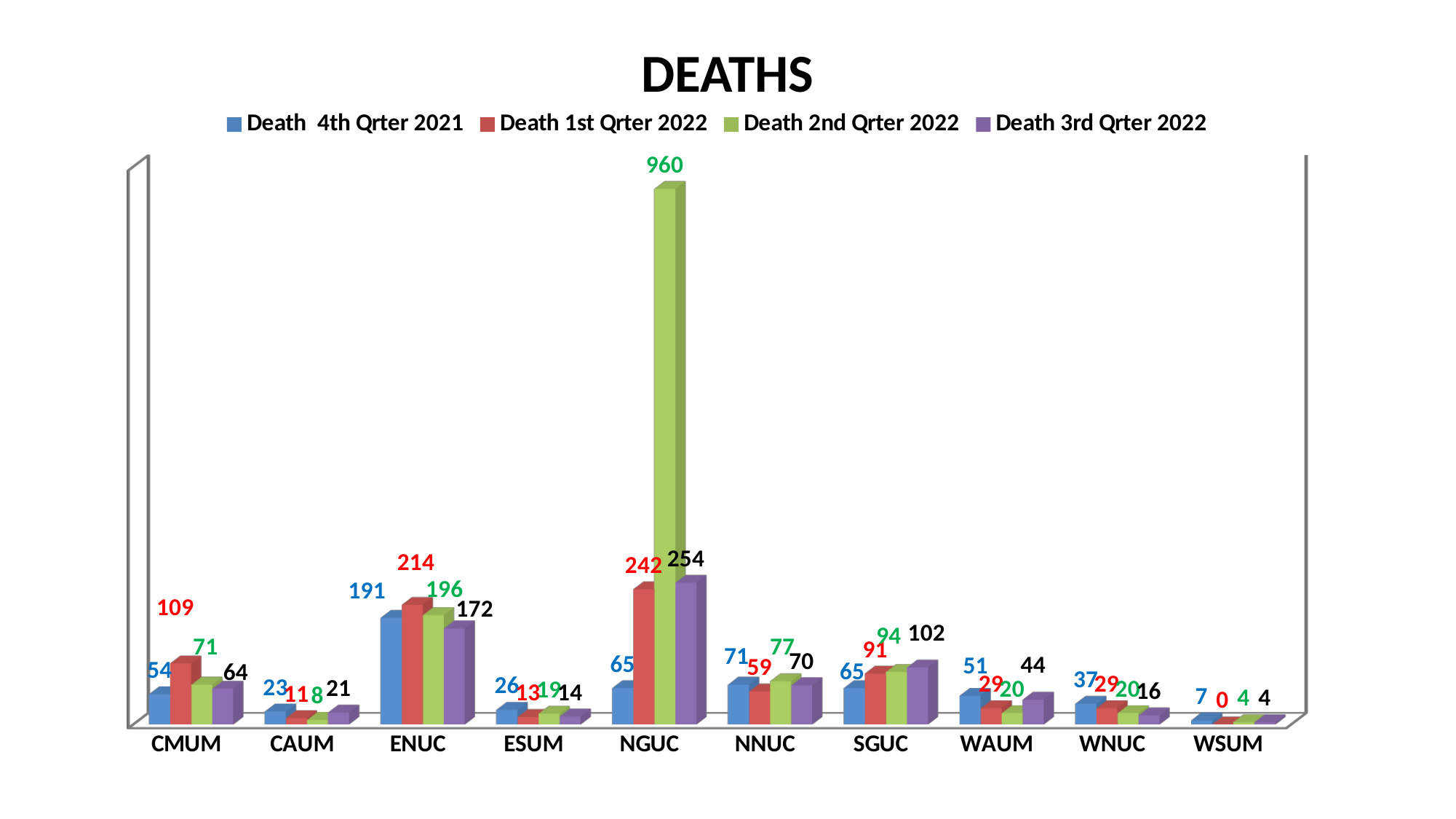
What kind of chart is shown on the slide? bar chart How many categories are shown on the x axis? 10 What is the value for ENUC in the Death 1st Qrter 2022 series? 214 What is the value for CMUM in the Death 4th Qrter 2021 series? 54 Which category has the highest value in the Death 2nd Qrter 2022 series? NGUC What is the title of the chart? DEATHS Which category has the lowest value in the Death 1st Qrter 2022 series? WSUM What is the value for SGUC in the Death 3rd Qrter 2022 series? 102 What is the difference between the Death 3rd Qrter 2022 value and the Death 1st Qrter 2022 value for NGUC? 12 How many series does the legend list? 4 What is the value for NGUC in the Death 2nd Qrter 2022 series? 960 Which is larger for WAUM: the Death 4th Qrter 2021 value or the Death 3rd Qrter 2022 value? Death 4th Qrter 2021